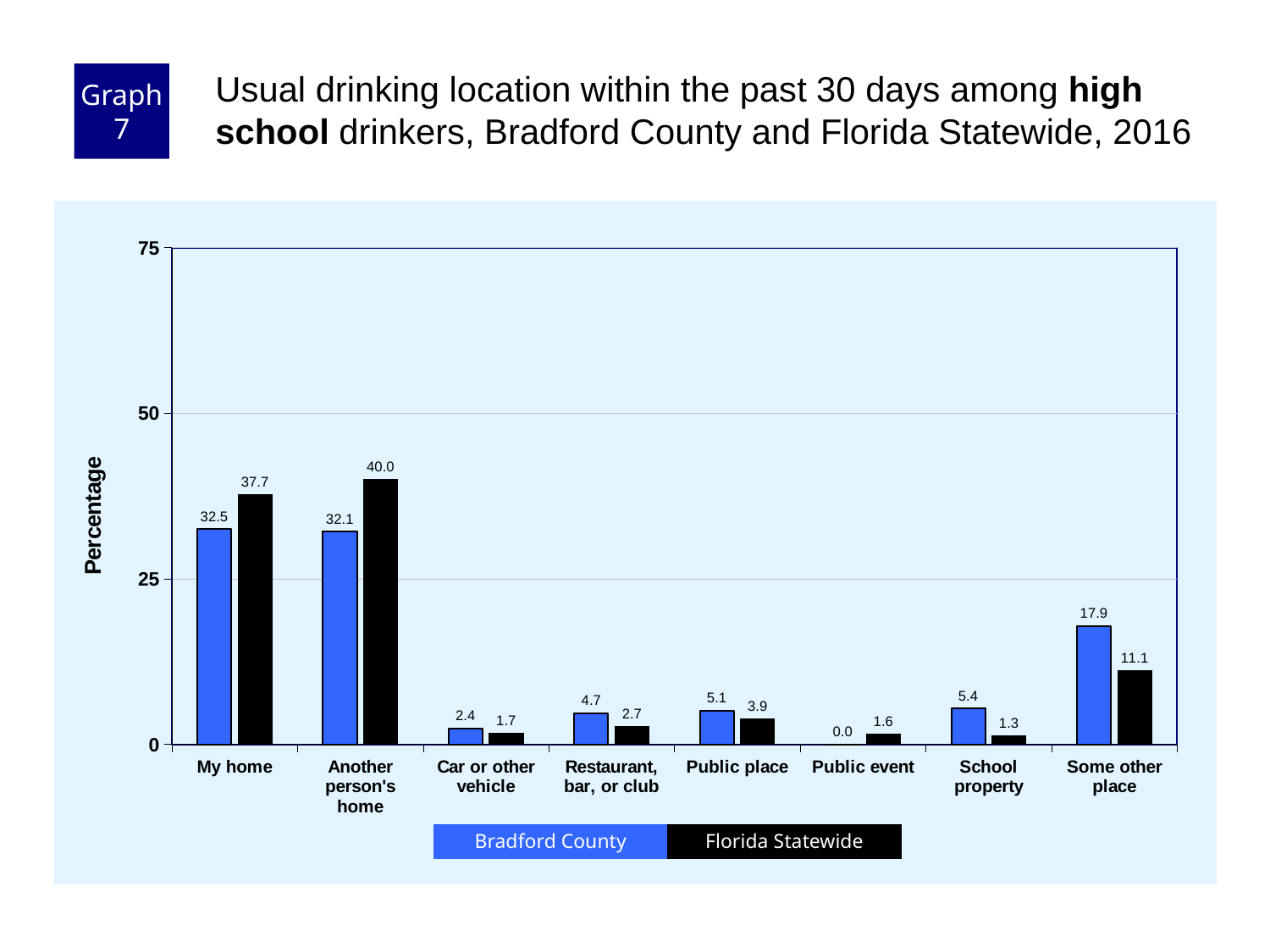
Which category has the lowest Bradford County value? Public event What is the Florida Statewide value for Another person's home? 40.0 How many location categories are shown on the x axis? 8 What is the difference between the Bradford County and Florida Statewide values for Some other place? 6.8 Is the Florida Statewide value for Another person's home greater or less than 25? greater Which category has the highest Florida Statewide value? Another person's home What kind of chart is shown on the slide? Bar chart What is the Bradford County value for My home? 32.5 What is the difference between the Florida Statewide and Bradford County values for My home? 5.2 How many series does the legend list? 2 Which is larger for School property: Bradford County or Florida Statewide? Bradford County What is the Bradford County value for Public event? 0.0